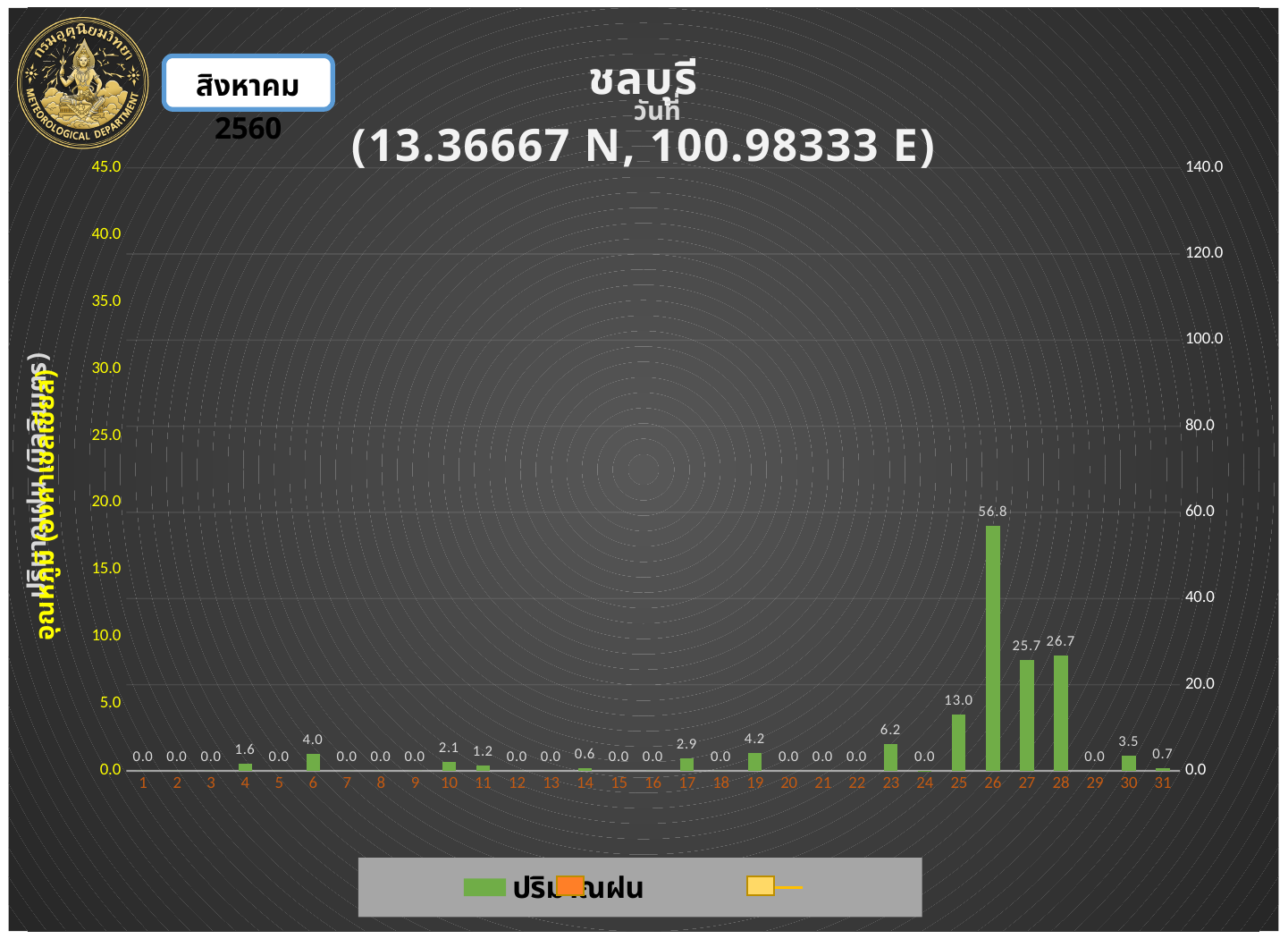
What is the value shown for day 30? 3.5 What is the value shown for day 23? 6.2 What is the difference between the values for day 28 and day 27? 1.0 What is the value labelled on the bar for day 25? 13.0 What is the rainfall value shown for day 26? 56.8 Which day has the highest rainfall value? 26 What is the name of the station shown in the chart title? ชลบุรี Which is larger, the value for day 27 or the value for day 28? day 28 What is the difference between the values for day 26 and day 25? 43.8 How many days are shown on the x axis? 31 Which is larger, the value for day 19 or the value for day 6? day 19 What kind of chart is shown on the slide? bar chart